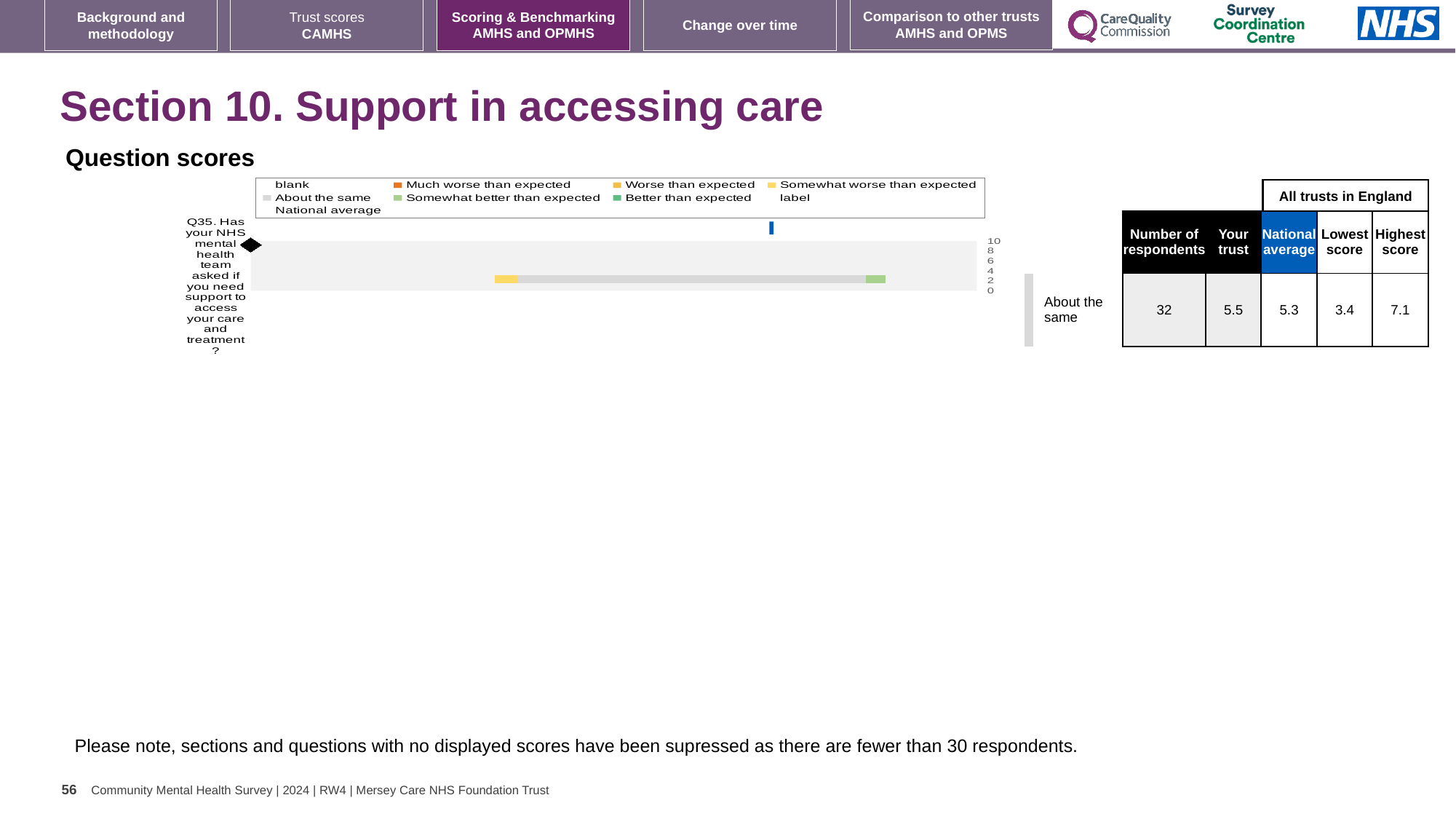
What is the trust's score for Q35 (Has your NHS mental health team asked if you need support to access your care and treatment?)? 5.5 What is the difference between the trust's score and the national average for Q35? 0.2 What is the highest score among all trusts in England for Q35? 7.1 What is the maximum value shown on the score axis of the Q35 chart? 10 What is the lowest score among all trusts in England for Q35? 3.4 What is the national average score for Q35? 5.3 What is the difference between the highest and lowest scores for Q35 across all trusts in England? 3.7 How is the trust's Q35 score categorised relative to what is expected? About the same How many respondents answered Q35? 32 Is the trust's score for Q35 higher or lower than the national average? higher What kind of chart is used to show the Q35 question score? bar chart How many questions are plotted in the Question scores chart? 1